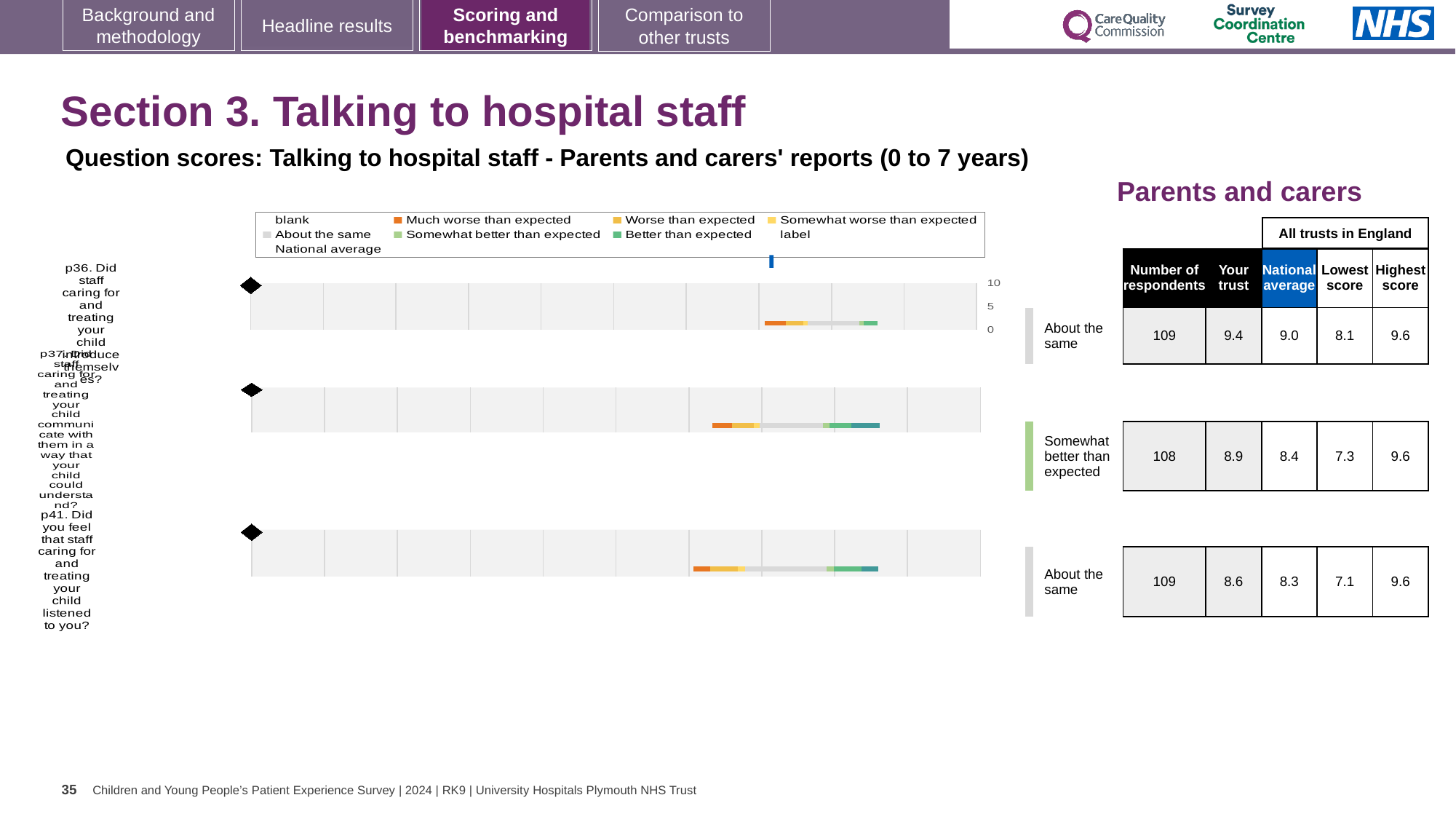
What kind of chart is used to show the p36 question score? bar chart According to the table beside the charts, what is the 'Your trust' score for p36? 9.4 According to the table beside the charts, how many respondents answered p37? 108 Which colour in the legend represents 'Much worse than expected'? orange How many question charts are shown on the slide? 3 What benchmark category label is shown next to the p37 chart? Somewhat better than expected What is the difference between the 'Your trust' score and the national average for p37? 0.5 Which has the larger 'Your trust' score, p36 or p41? p36 What is the highest tick value shown on the axis of the top chart? 10 How many entries does the legend above the charts list? 9 Which question has the highest 'Your trust' score in the table beside the charts? p36 According to the table beside the charts, what is the national average for p37? 8.4